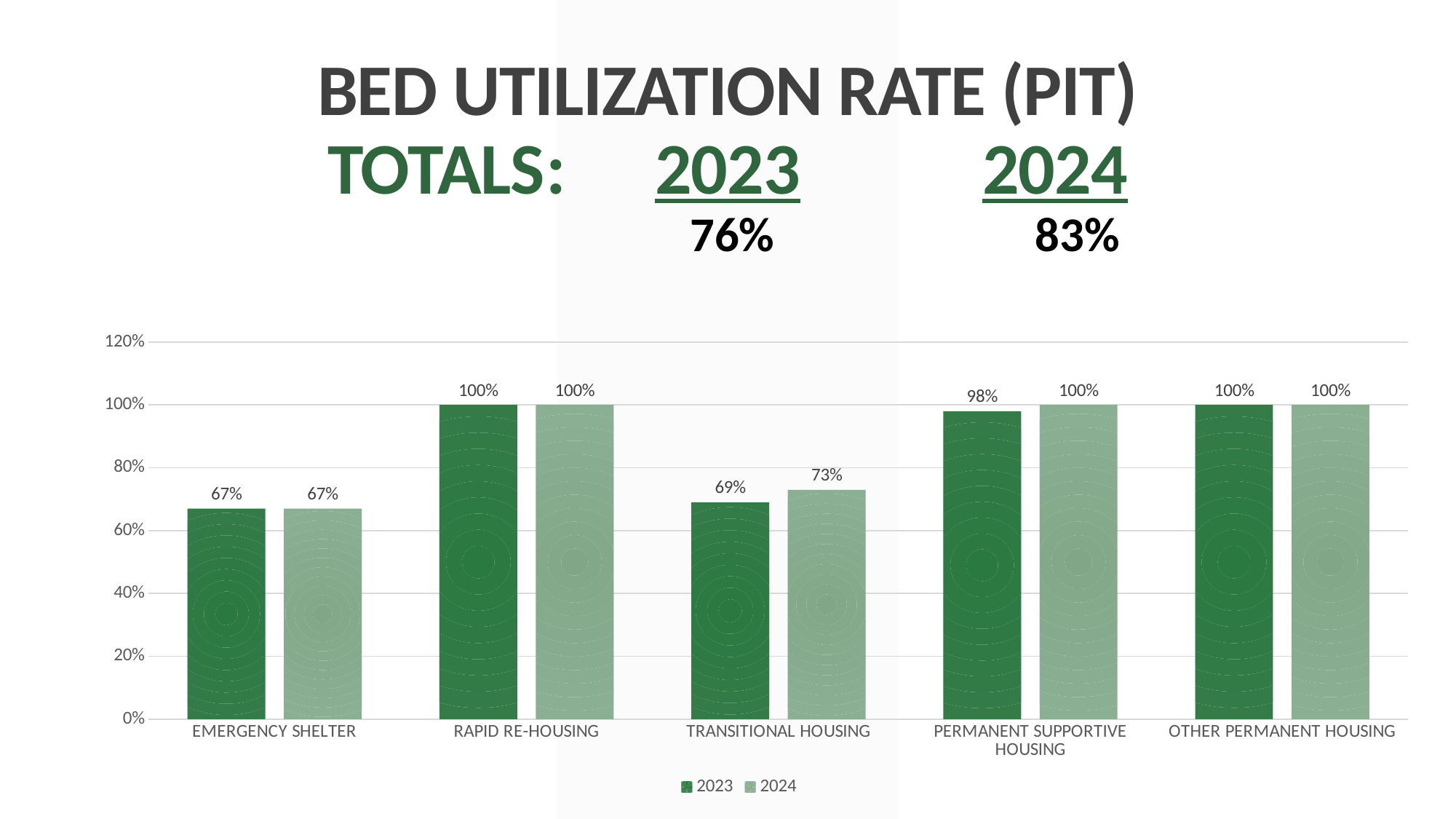
How many categories are shown on the x axis? 5 Which category has the lowest 2023 bed utilization rate? Emergency Shelter What is the title of the chart? Bed Utilization Rate (PIT) What kind of chart is shown on the slide? Bar chart What is the 2023 bed utilization rate for Emergency Shelter? 67% What is the 2024 bed utilization rate for Transitional Housing? 73% What is the difference between the 2024 and 2023 rates for Transitional Housing? 4% Which category has the lowest 2024 bed utilization rate? Emergency Shelter Which is larger: the 2023 rate for Transitional Housing or the 2023 rate for Permanent Supportive Housing? Permanent Supportive Housing What is the 2023 bed utilization rate for Permanent Supportive Housing? 98% How many series does the legend list? 2 What is the difference between the 2024 and 2023 rates for Permanent Supportive Housing? 2%